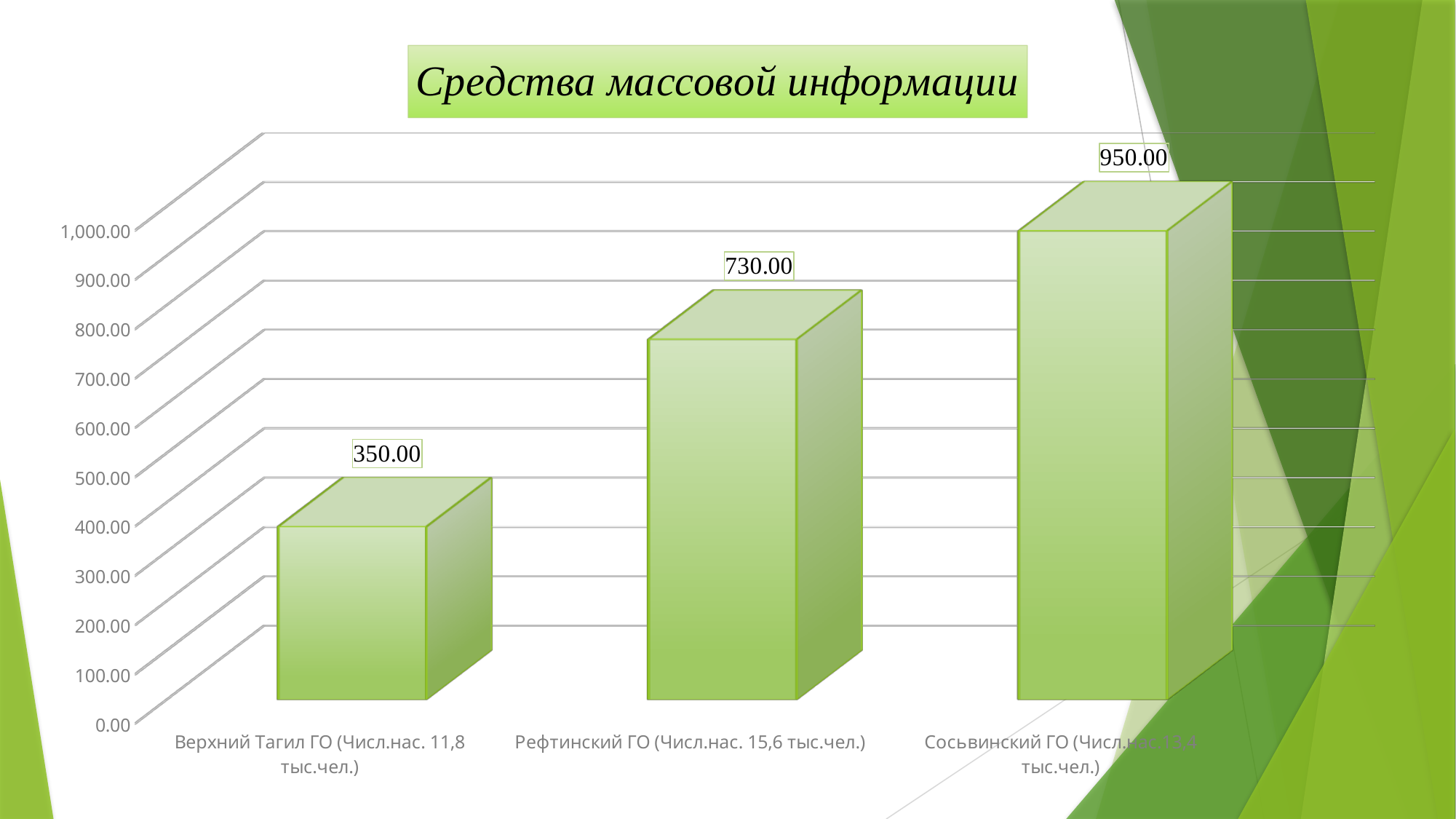
Is the value for Сосьвинский ГО greater or less than 900.00? greater What is the difference between the values for Рефтинский ГО and Верхний Тагил ГО? 380.00 What is the value for Сосьвинский ГО? 950.00 Which is larger, the value for Рефтинский ГО or the value for Верхний Тагил ГО? Рефтинский ГО What kind of chart is shown on the slide? bar chart What is the difference between the values for Сосьвинский ГО and Рефтинский ГО? 220.00 How many categories are shown in the chart? 3 What is the value for Рефтинский ГО? 730.00 Which category has the highest value? Сосьвинский ГО What is the title of the chart? Средства массовой информации Which category has the lowest value? Верхний Тагил ГО What is the value for Верхний Тагил ГО? 350.00